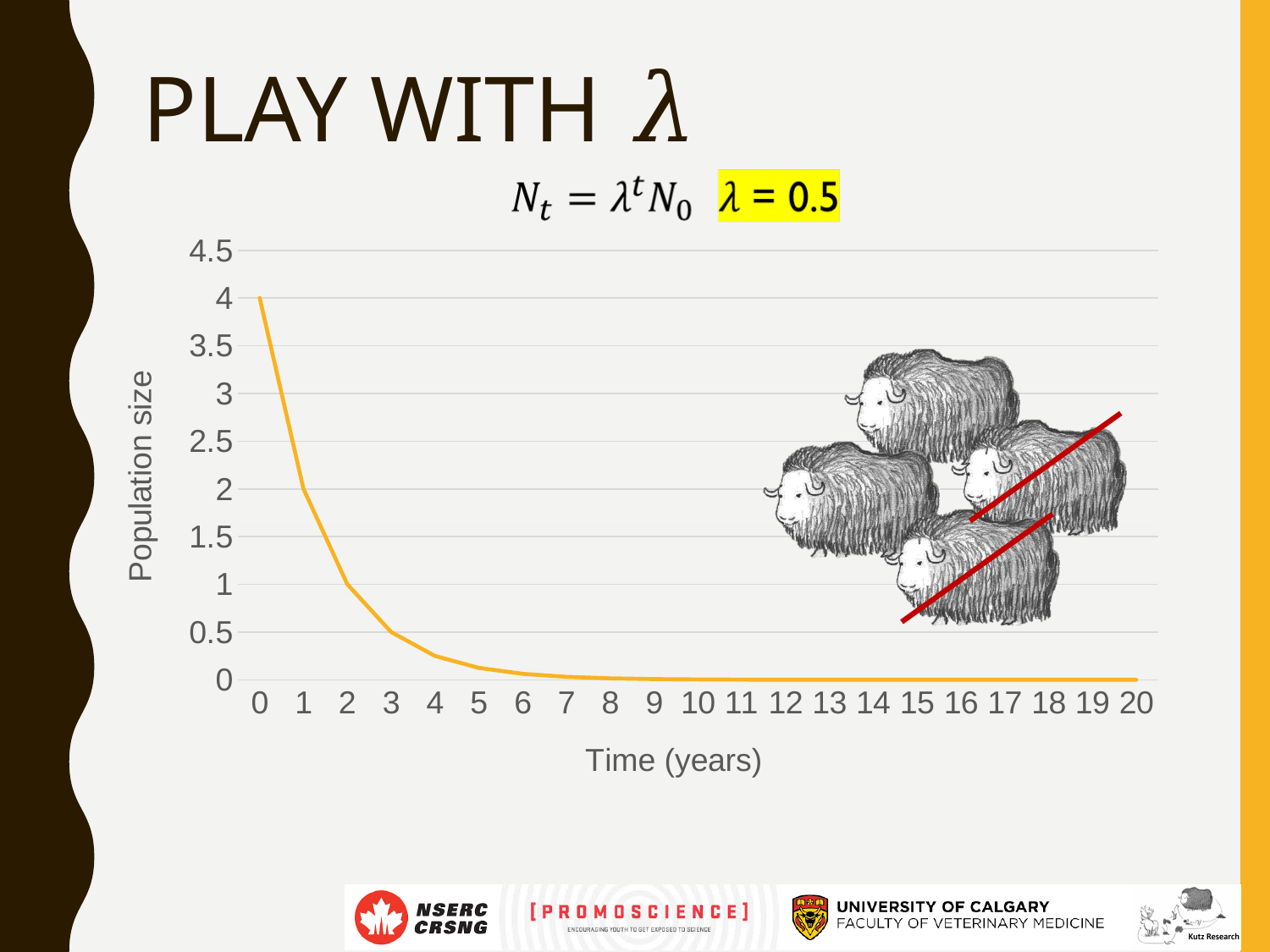
Which is larger, the population size at year 1 or at year 3? year 1 What is the population size at time 0 years? 4 Is the population size at year 5 greater or less than 0.5? less At which time (in years) is the population size highest? 0 What kind of chart is shown on the slide? line chart Does the population size rise or fall as time increases along the x axis? fall What is the population size at time 2 years? 1 What is the population size at time 1 year? 2 What is the difference between the population size at year 0 and at year 1? 2 What is the population size at time 3 years? 0.5 What is the title of the x axis? Time (years) How many time points (years) are labelled on the x axis? 21